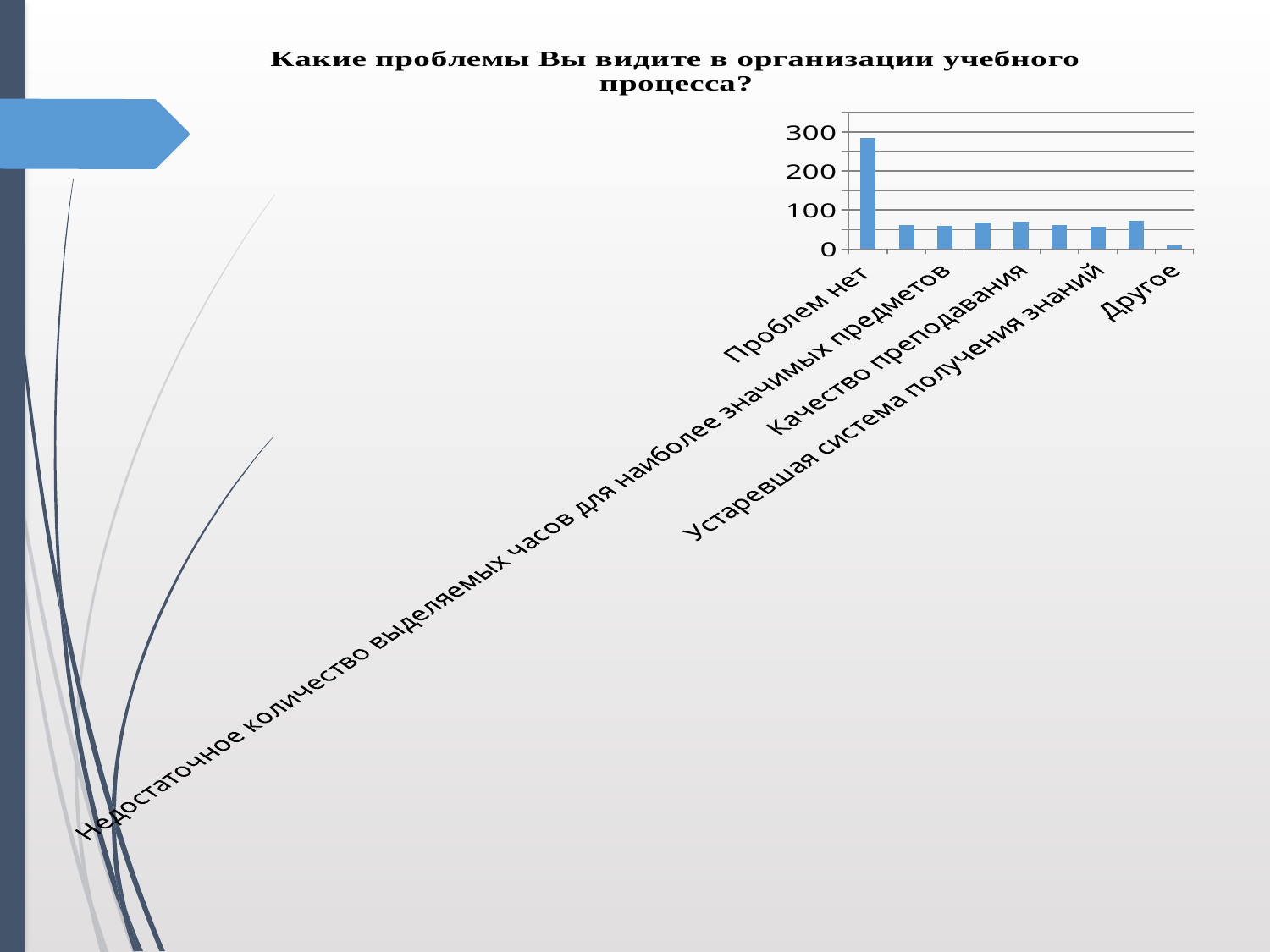
Which category has the highest value? Проблем нет How many bars are plotted in the chart? 9 What is the highest tick value shown on the vertical axis? 300 Which is larger, the value for Проблем нет or the value for Другое? Проблем нет What kind of chart is shown on the slide? bar chart Is the value for Качество преподавания greater or less than 100? less Is the value for Проблем нет greater or less than 200? greater Which category has the lowest value? Другое Is the value for Другое greater or less than 100? less What is the title of the chart? Какие проблемы Вы видите в организации учебного процесса? Which is larger, the value for Проблем нет or the value for Качество преподавания? Проблем нет